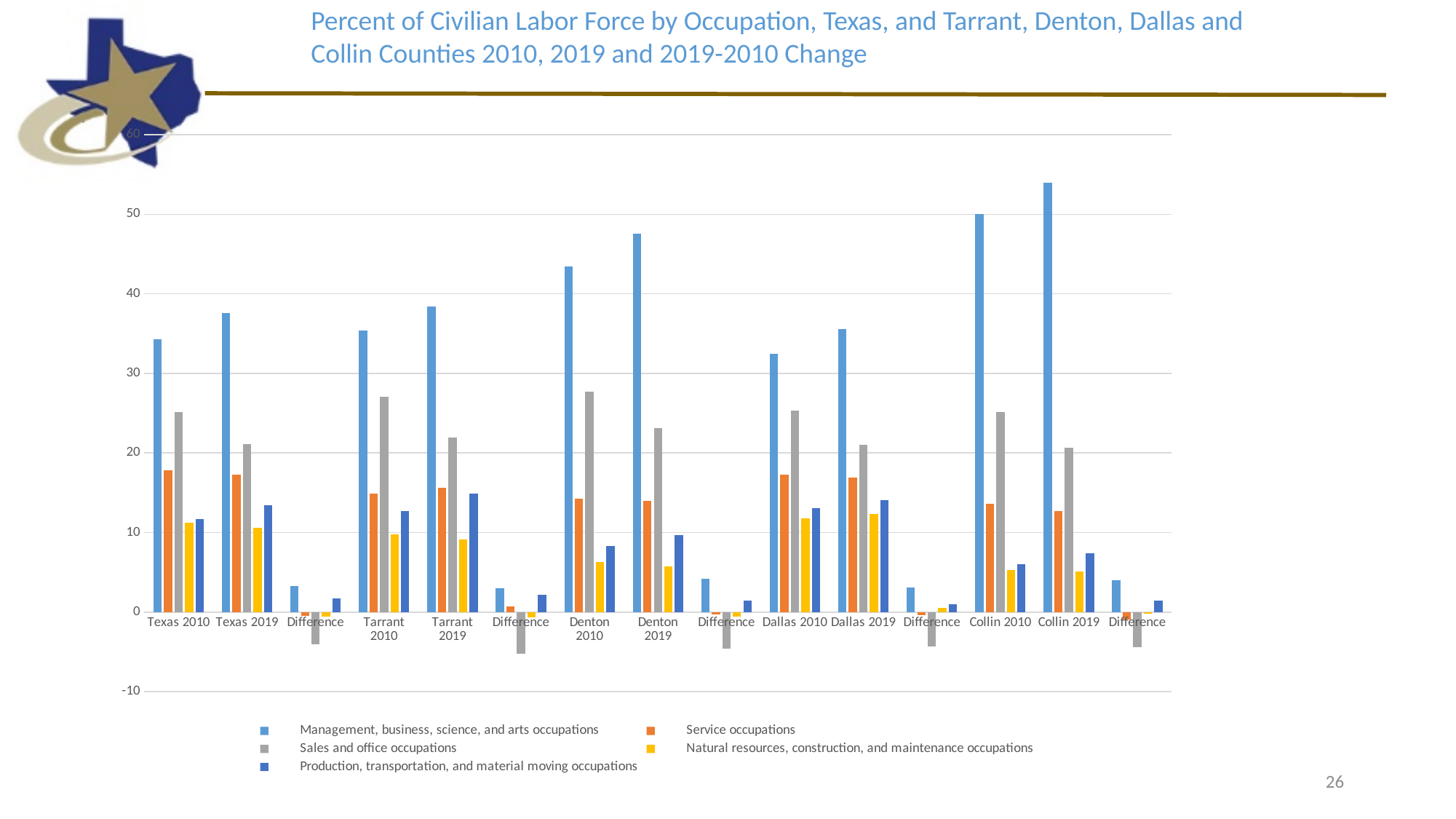
What kind of chart is shown on the slide? Bar chart Is the value for Management, business, science, and arts occupations in Denton 2019 greater or less than 50? less Which is larger for Management, business, science, and arts occupations: Collin 2010 or Collin 2019? Collin 2019 Does the value for Management, business, science, and arts occupations rise or fall from Dallas 2010 to Dallas 2019? Rise Which is larger for Sales and office occupations: Texas 2010 or Texas 2019? Texas 2010 How many series does the legend list? 5 How many categories are shown along the x axis? 15 Which series has the highest value in the Collin 2019 category? Management, business, science, and arts occupations Is the value for Service occupations in Texas 2010 greater or less than 20? less What colour represents Management, business, science, and arts occupations in the legend? Light blue Is the value for Management, business, science, and arts occupations in Collin 2019 greater or less than 50? greater